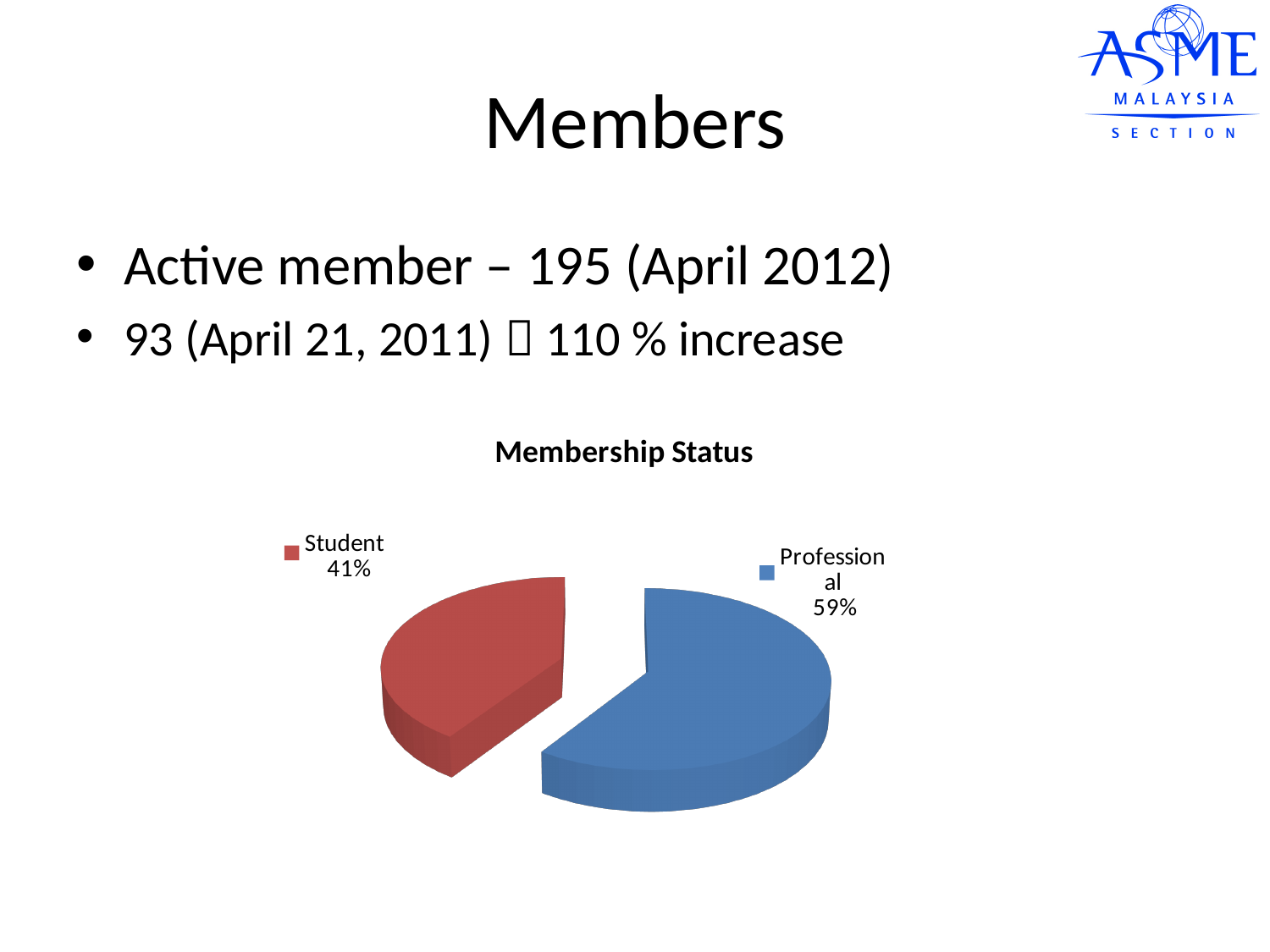
What kind of chart is shown on the slide? pie chart What is the difference in percentage points between the Professional and Student slices? 18% Which is larger, the Student slice or the Professional slice? Professional Which category has the largest slice of the pie? Professional What colour is the Student slice? red What is the title of the chart? Membership Status How many slices does the pie chart have? 2 What share of the pie does the Student slice represent? 41% Is the share for Student greater or less than 50%? less What share of the pie does the Professional slice represent? 59% Which category has the smallest slice of the pie? Student